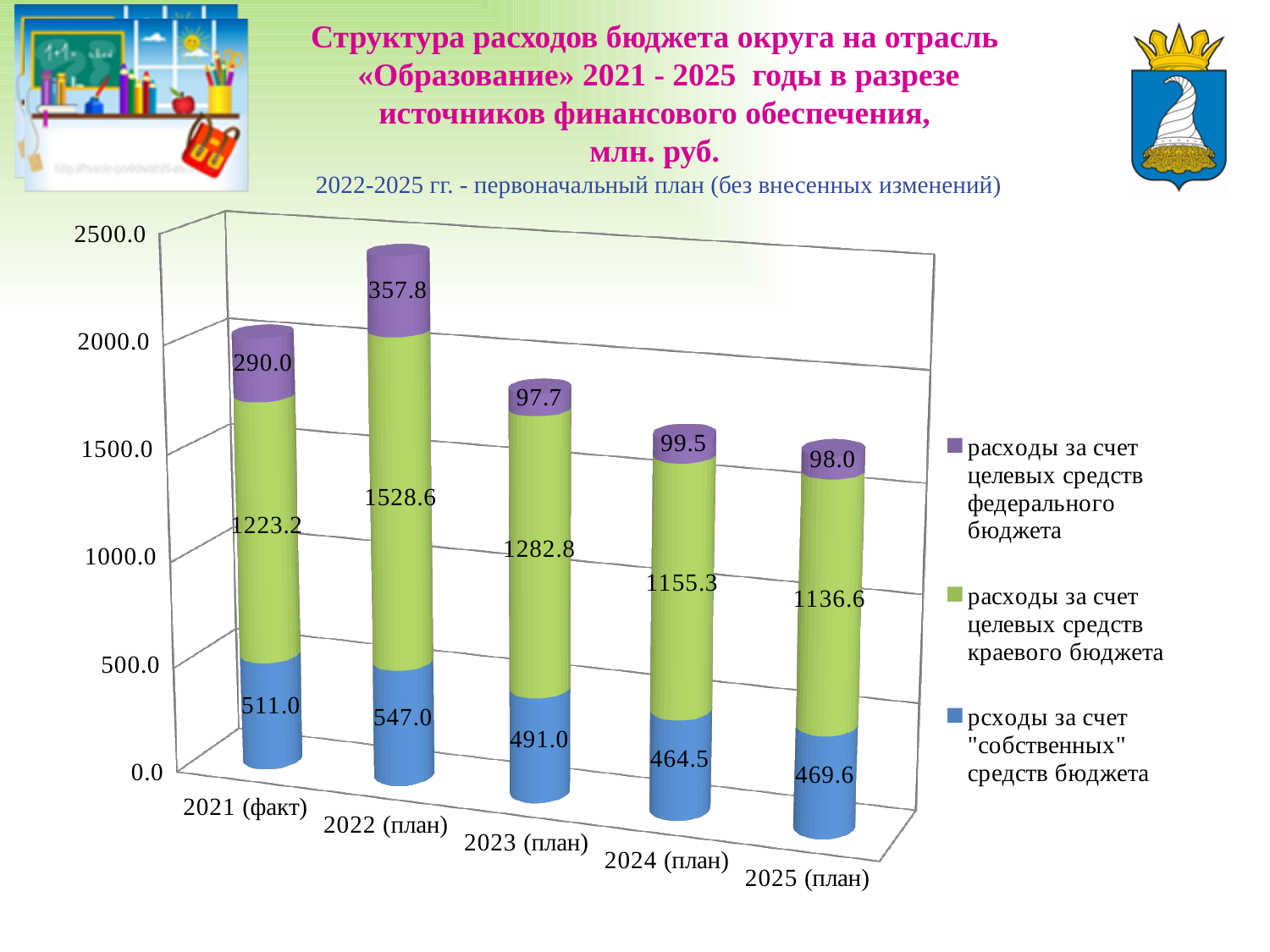
What is the value of расходы за счет целевых средств федерального бюджета for 2021 (факт)? 290.0 What is the value of расходы за счет целевых средств краевого бюджета for 2022 (план)? 1528.6 Which is larger: расходы за счет "собственных" средств бюджета for 2021 (факт) or for 2022 (план)? 2022 (план) Which year has the lowest value for расходы за счет "собственных" средств бюджета? 2024 (план) What is the difference between the расходы за счет целевых средств краевого бюджета values for 2022 (план) and 2023 (план)? 245.8 What is the total of the stacked bar for 2023 (план)? 1871.5 How many years (categories) are shown on the x axis? 5 What kind of chart is shown on the slide? Stacked bar chart Which year has the highest value for расходы за счет целевых средств федерального бюджета? 2022 (план) What is the value of расходы за счет "собственных" средств бюджета for 2025 (план)? 469.6 Does the value of расходы за счет целевых средств краевого бюджета rise or fall from 2022 (план) to 2025 (план)? Fall How many series does the legend list? 3